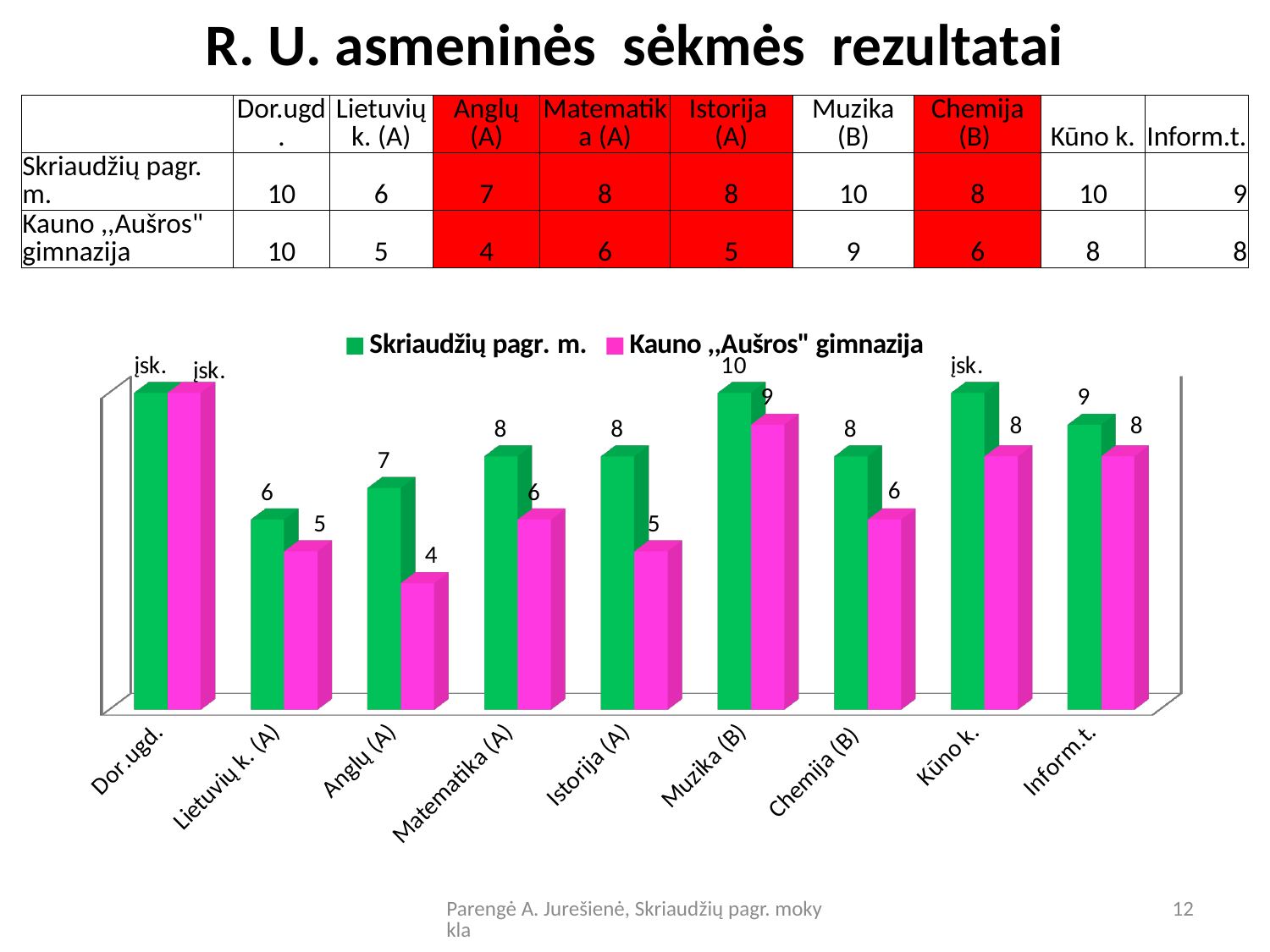
What is the value for Kauno ,,Aušros" gimnazija in Muzika (B)? 9 What is the difference between Skriaudžių pagr. m. and Kauno ,,Aušros" gimnazija in Anglų (A)? 3 What type of chart is shown on the slide? bar chart Which subject has the lowest value for Kauno ,,Aušros" gimnazija? Anglų (A) What label is shown on the bars for Dor.ugd. instead of a number? įsk. How many series does the chart legend list? 2 What is the value for Skriaudžių pagr. m. in Inform.t.? 9 Which is larger in Chemija (B): Skriaudžių pagr. m. or Kauno ,,Aušros" gimnazija? Skriaudžių pagr. m. What is the value for Skriaudžių pagr. m. in Anglų (A)? 7 What is the value for Kauno ,,Aušros" gimnazija in Istorija (A)? 5 How many subject categories are shown on the chart's x axis? 9 What is the difference between Skriaudžių pagr. m. and Kauno ,,Aušros" gimnazija in Matematika (A)? 2